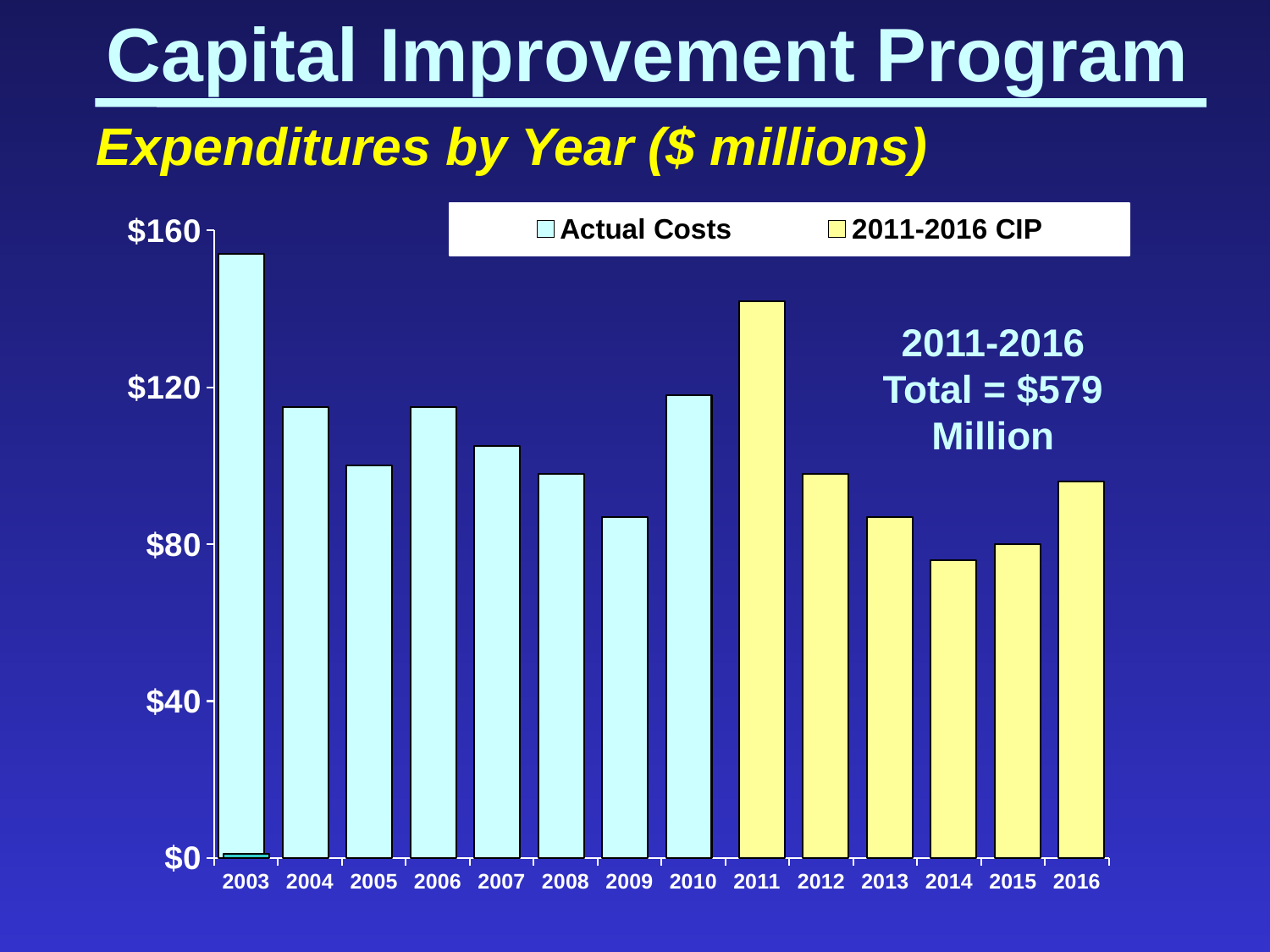
Which year has the lowest expenditure in the chart? 2014 What kind of chart is shown on the slide? bar chart Is the expenditure for 2011 greater or less than $120? greater Is the expenditure for 2003 greater or less than $120? greater Which year has the larger expenditure, 2009 or 2010? 2010 Is the expenditure for 2014 greater or less than $80? less Which year has the highest expenditure in the chart? 2003 How many series does the chart legend list? 2 According to the text on the chart, what is the 2011-2016 total? $579 Million Which year has the larger expenditure, 2003 or 2011? 2003 How many years are shown along the x axis of the chart? 14